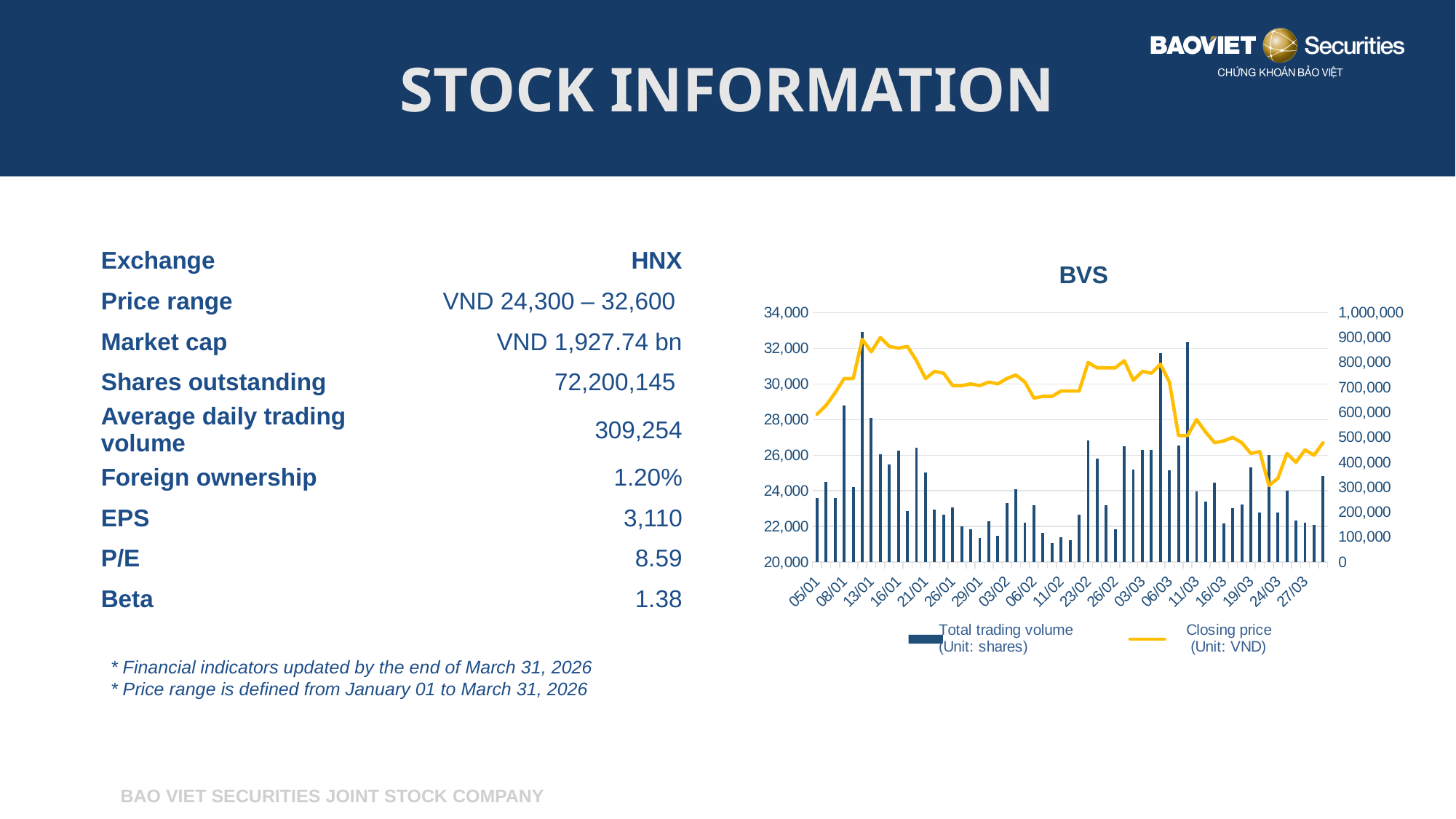
Is the closing price at 05/01 greater or less than 30,000? less What kind of chart is shown on the slide? Combined bar and line chart Is the total trading volume at 11/02 greater or less than 200,000? less Which series in the chart is drawn as a line? Closing price (Unit: VND) Does the closing price rise or fall between 06/03 and 11/03? fall How many date labels are shown on the x axis of the chart? 19 Is the closing price at 24/03 greater or less than 26,000? less How many series does the chart legend list? 2 Does the closing price rise or fall between 05/01 and 13/01? rise What is the title of the chart? BVS